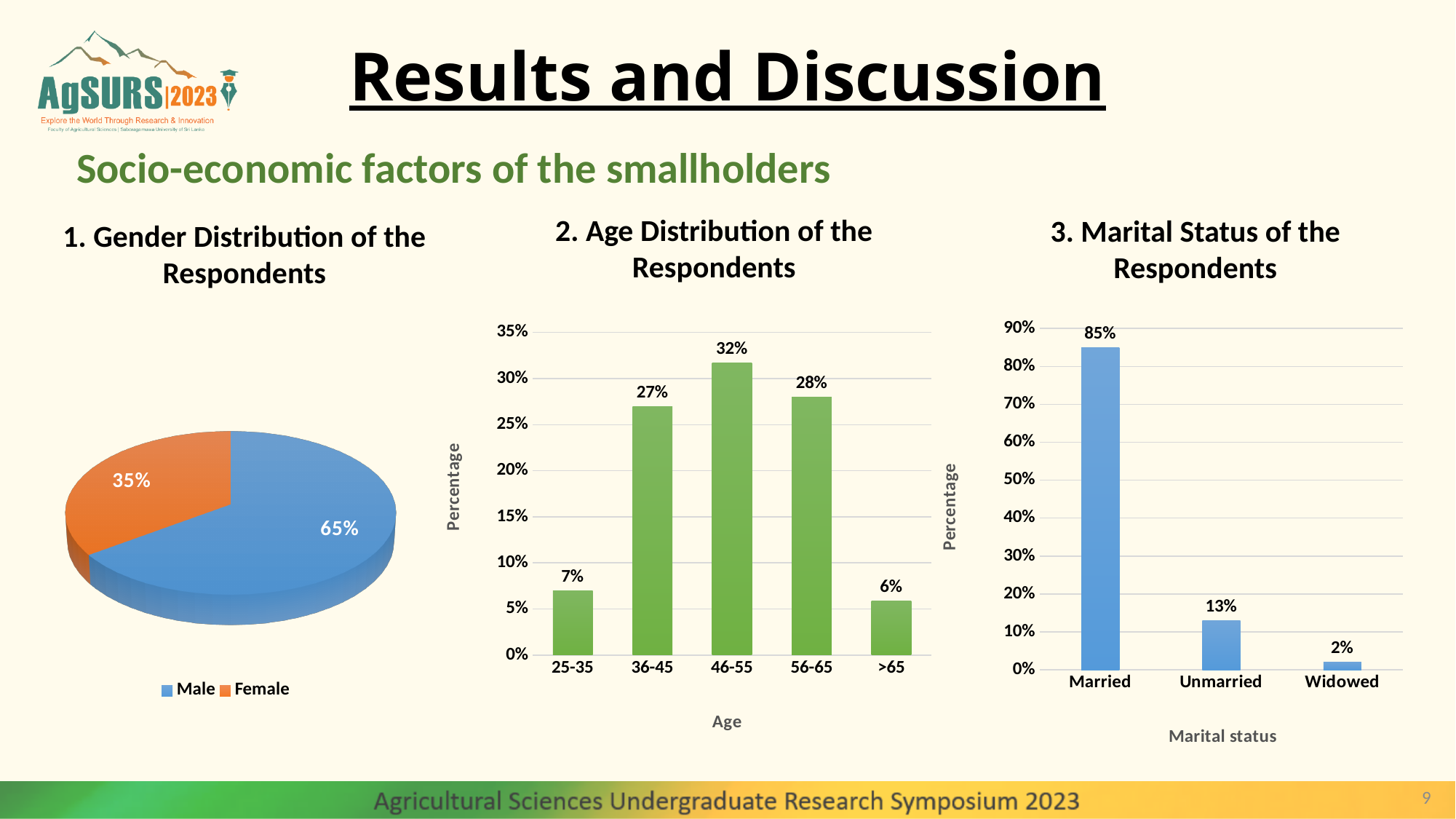
In the Marital Status of the Respondents chart, which is larger, Unmarried or Widowed? Unmarried What kind of chart is the Gender Distribution of the Respondents chart? Pie chart In the Marital Status of the Respondents chart, what is the difference between Married and Widowed? 83% In the Age Distribution of the Respondents chart, what is the difference between the 56-65 and 36-45 age groups? 1% In the Age Distribution of the Respondents chart, which age group has the highest percentage? 46-55 In the Age Distribution of the Respondents chart, what is the value for the 46-55 age group? 32% What kind of chart is the Marital Status of the Respondents chart? Bar chart In the Age Distribution of the Respondents chart, which age group has the lowest percentage? >65 In the Gender Distribution of the Respondents chart, what percentage of respondents are Female? 35% In the Gender Distribution of the Respondents chart, what percentage of respondents are Male? 65% In the Marital Status of the Respondents chart, what is the value for Unmarried? 13% How many age groups are shown in the Age Distribution of the Respondents chart? 5